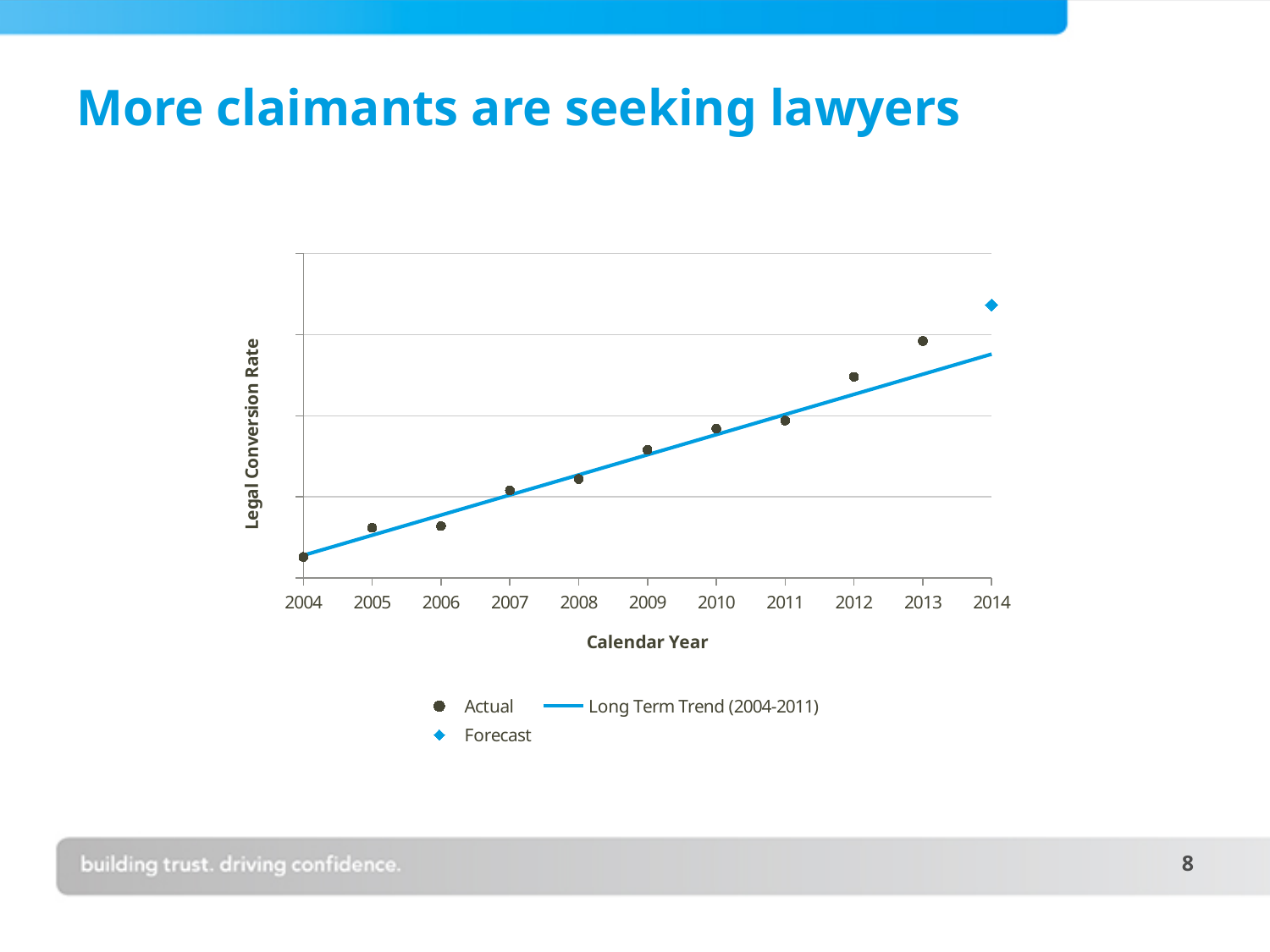
How many years are labelled along the x axis of the chart? 11 Is the 2013 Actual point above or below the Long Term Trend line? above How many Actual data points are plotted on the chart? 10 Which year has the higher Actual legal conversion rate, 2005 or 2012? 2012 How many series does the chart's legend list? 3 What is the title of the slide containing the chart? More claimants are seeking lawyers Which year has the lowest Actual legal conversion rate on the chart? 2004 Which year is the Forecast point plotted for? 2014 Which year has the highest Actual legal conversion rate on the chart? 2013 What are the three series listed in the chart's legend? Actual, Long Term Trend (2004-2011), Forecast Does the Actual legal conversion rate rise or fall from 2004 to 2013? rise What kind of chart is shown on the slide? scatter chart